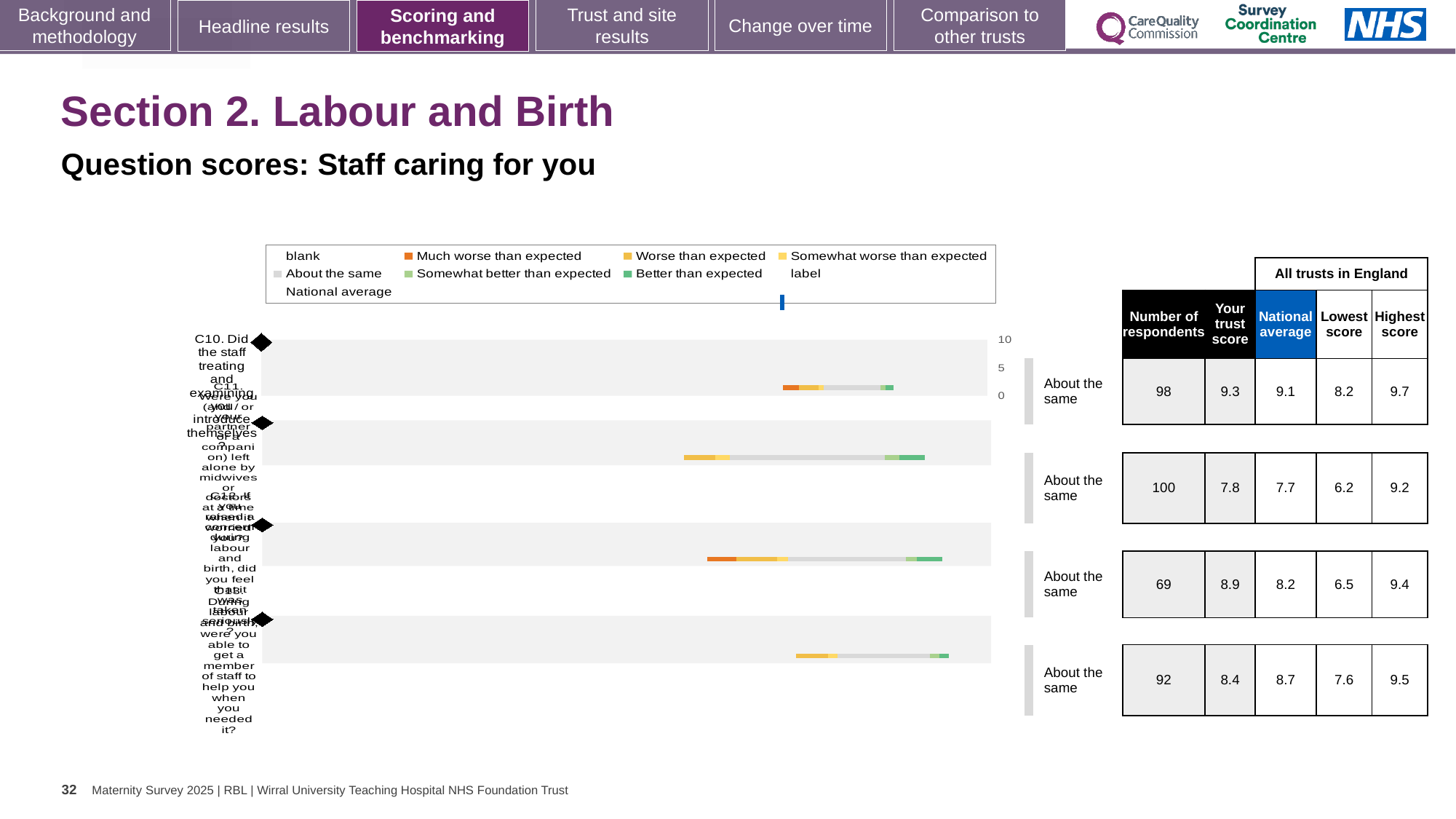
What benchmark category is shown for every question row in the chart? About the same What is the difference between the trust score and the national average for the third question row (C12)? 0.7 How many questions (rows) are plotted in the chart? 4 What is the trust score for the first question row (C10)? 9.3 What is the lowest score across all trusts in England for the third question row (C12)? 6.5 Which question row has the lowest number of respondents? C12 (third row) What is the number of respondents for the first question row (C10)? 98 What is the highest score across all trusts in England for the fourth question row (C13)? 9.5 Is the trust score for the fourth question row (C13) higher or lower than its national average? lower What is the national average for the second question row (C11)? 7.7 What kind of chart is shown on the slide? bar chart Which question row has the highest trust score? C10 (first row)